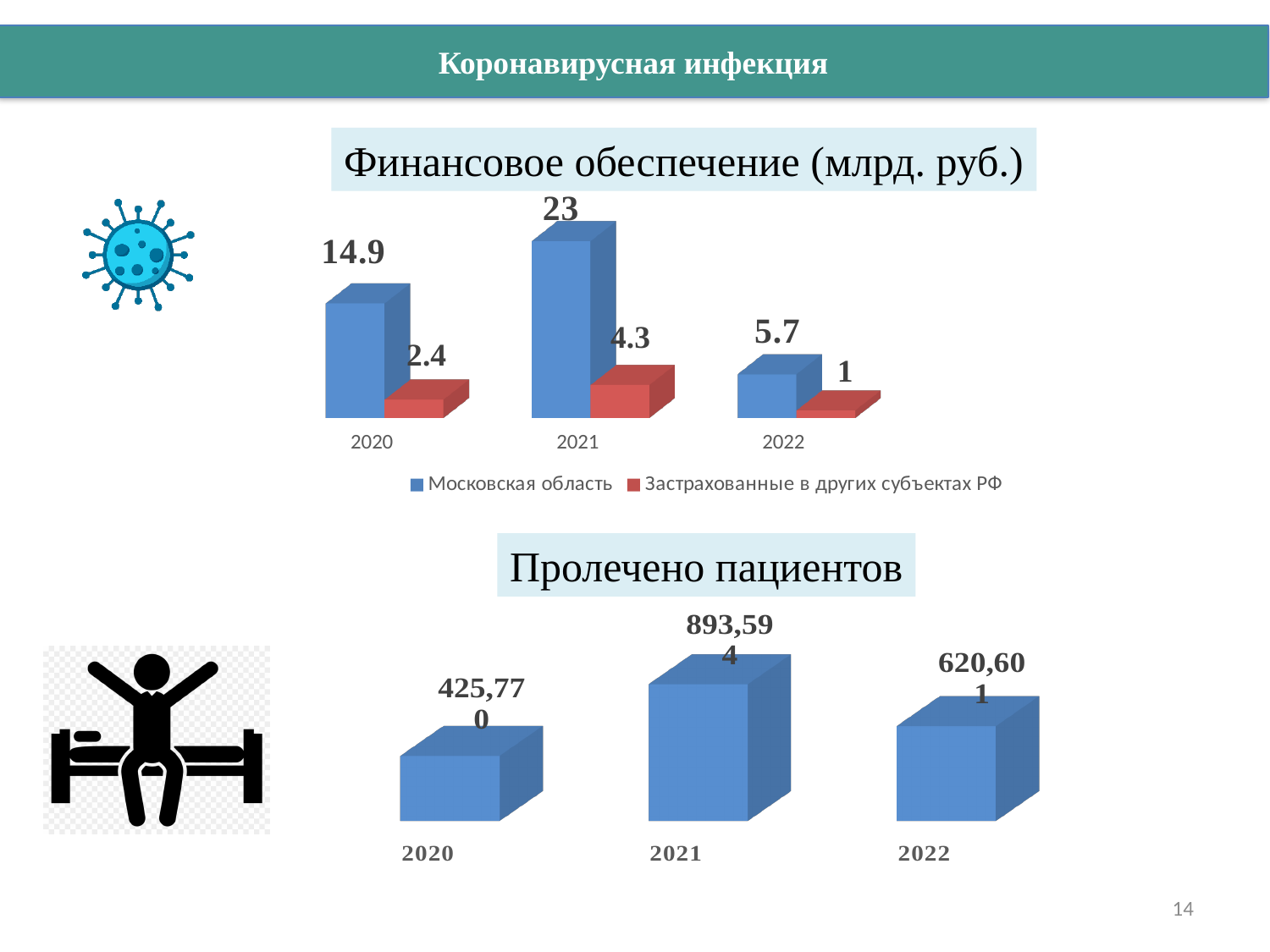
In the chart 'Пролечено пациентов', what is the value for 2021? 893,594 In the chart 'Финансовое обеспечение (млрд. руб.)', what is the value for Застрахованные в других субъектах РФ in 2020? 2.4 In the chart 'Финансовое обеспечение (млрд. руб.)', how many series does the legend list? 2 In the chart 'Финансовое обеспечение (млрд. руб.)', which year has the lowest value for Застрахованные в других субъектах РФ? 2022 What kind of chart is 'Пролечено пациентов'? Bar chart In the chart 'Финансовое обеспечение (млрд. руб.)', what is the value for Московская область in 2021? 23 In the chart 'Финансовое обеспечение (млрд. руб.)', what colour are the bars for Московская область? Blue In the chart 'Финансовое обеспечение (млрд. руб.)', what is the difference between the Московская область values for 2021 and 2022? 17.3 In the chart 'Финансовое обеспечение (млрд. руб.)', which year has the highest value for Московская область? 2021 In the chart 'Пролечено пациентов', is the value for 2022 larger or smaller than the value for 2020? Larger In the chart 'Пролечено пациентов', which year has the lowest value? 2020 In the chart 'Пролечено пациентов', how many years are shown? 3